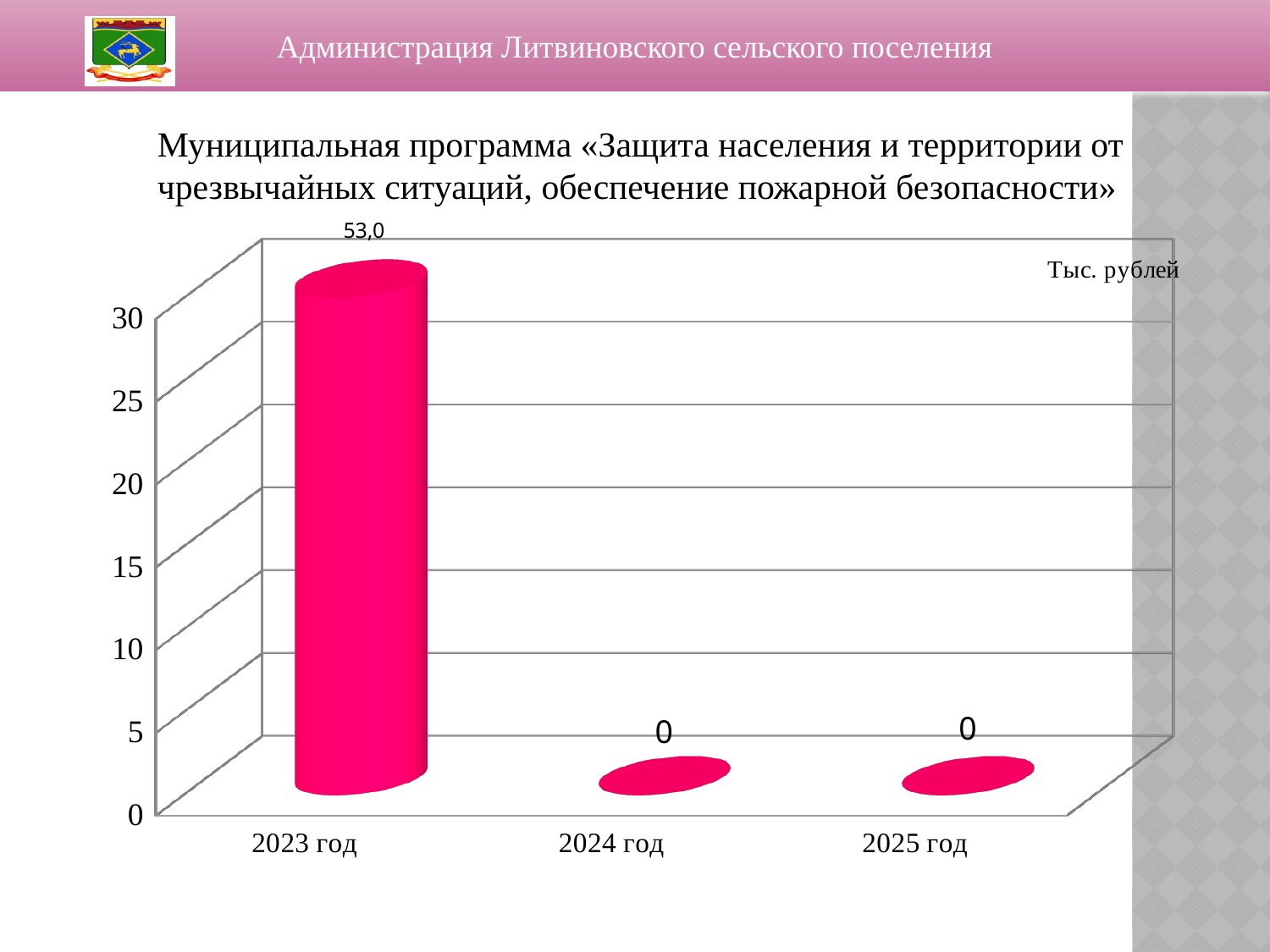
What colour are the bars in the chart? pink What is the difference between the values for 2023 год and 2024 год? 53,0 How many years are shown on the x axis? 3 What unit of measurement is indicated on the chart? Тыс. рублей What is the value for 2023 год? 53,0 What is the value for 2024 год? 0 Do the values rise or fall from 2023 год to 2024 год? fall What kind of chart is shown on the slide? bar chart What is the value for 2025 год? 0 Which is larger, the value for 2023 год or the value for 2025 год? 2023 год Which year has the highest value? 2023 год